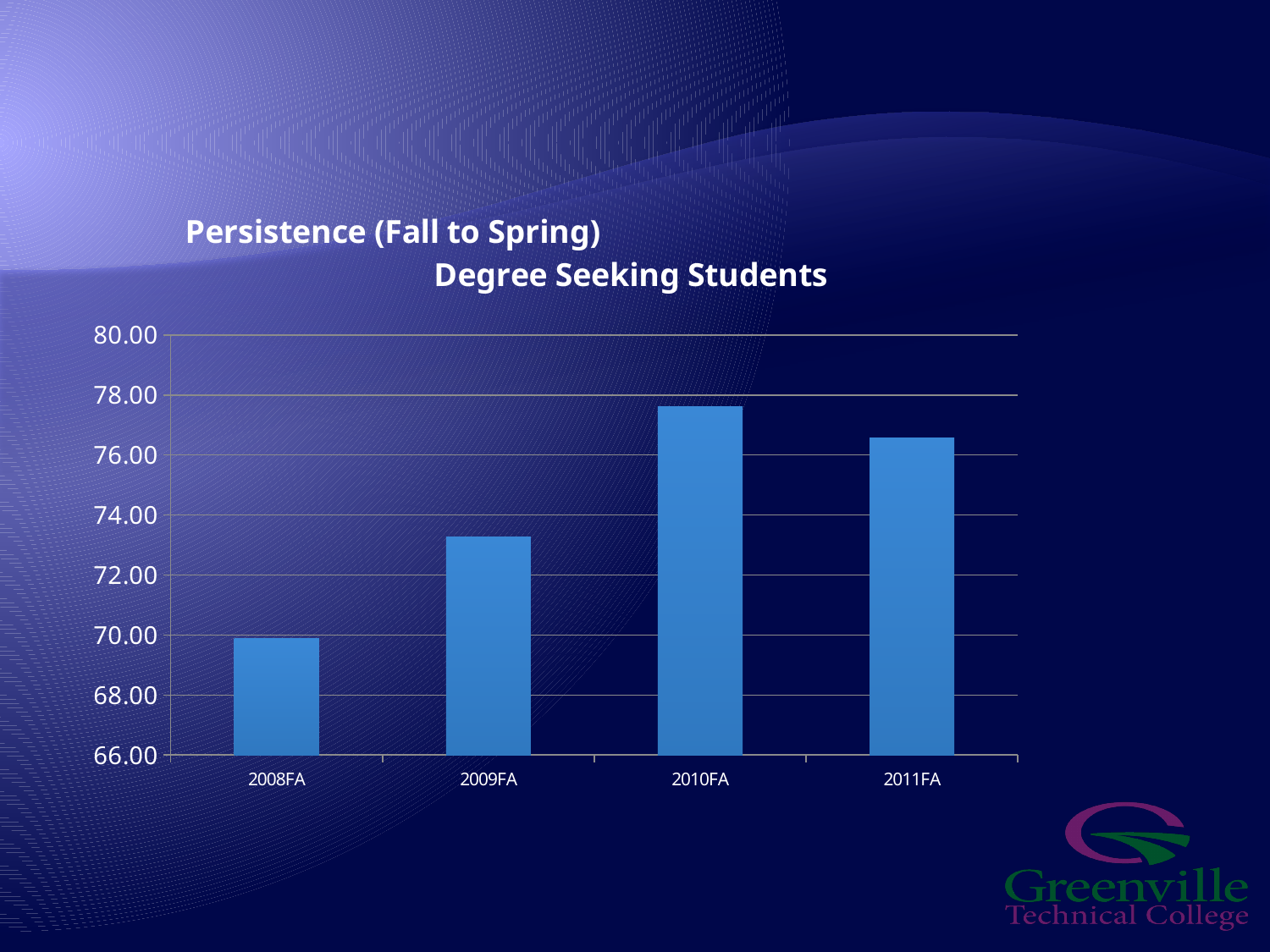
Which term has the lowest persistence value in the chart? 2008FA Which term has the highest persistence value in the chart? 2010FA What kind of chart is shown on the slide? bar chart What is the title of the chart? Persistence (Fall to Spring) Degree Seeking Students How many categories (terms) are shown on the x axis of the chart? 4 Do the values rise or fall from 2008FA to 2010FA? rise Which is larger, the value for 2010FA or the value for 2011FA? 2010FA Is the value for 2009FA greater or less than 74.00? less Is the value for 2009FA greater or less than 72.00? greater Which is larger, the value for 2008FA or the value for 2009FA? 2009FA Is the value for 2011FA greater or less than 76.00? greater